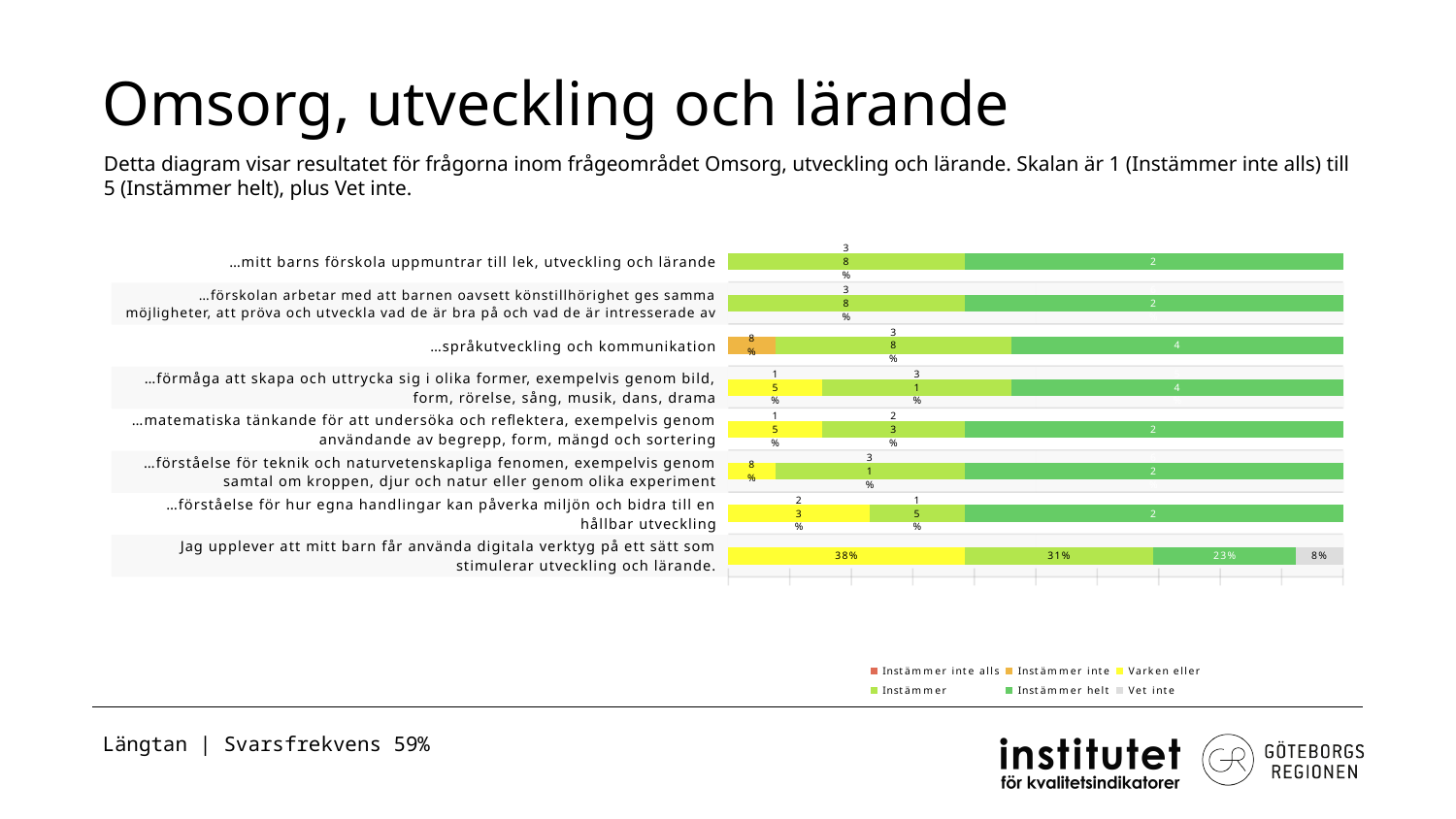
What kind of chart is shown on the slide? Stacked bar chart How many series does the legend list? 6 For 'Jag upplever att mitt barn får använda digitala verktyg...', what is the difference between the Varken eller and Instämmer values? 7% What is the Instämmer helt value for 'Jag upplever att mitt barn får använda digitala verktyg på ett sätt som stimulerar utveckling och lärande'? 23% What is the Vet inte value for 'Jag upplever att mitt barn får använda digitala verktyg på ett sätt som stimulerar utveckling och lärande'? 8% What is the Instämmer value for 'Jag upplever att mitt barn får använda digitala verktyg på ett sätt som stimulerar utveckling och lärande'? 31% What is the total of the labelled segments in the bar for 'Jag upplever att mitt barn får använda digitala verktyg...'? 100% For 'Jag upplever att mitt barn får använda digitala verktyg...', which response option has the smallest share? Vet inte What is the Varken eller value for 'Jag upplever att mitt barn får använda digitala verktyg på ett sätt som stimulerar utveckling och lärande'? 38% What is the title of the slide containing the chart? Omsorg, utveckling och lärande How many categories (questions) are plotted in the chart? 8 For 'Jag upplever att mitt barn får använda digitala verktyg...', which is larger: Varken eller or Instämmer helt? Varken eller